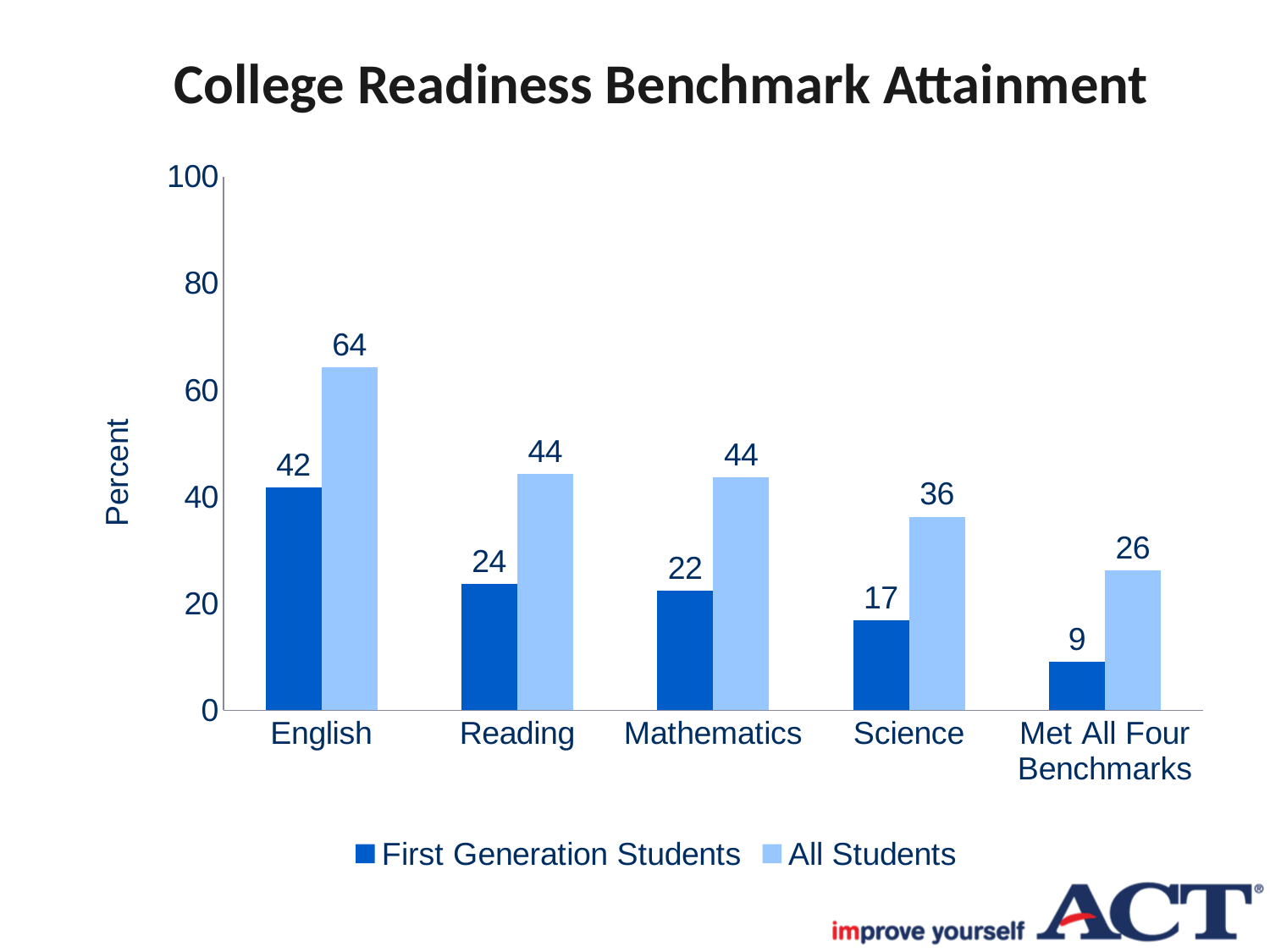
What is the value for All Students in Science? 36 Which category has the highest value for All Students? English Which is larger: the First Generation Students value for Reading or for Mathematics? Reading What is the difference between All Students and First Generation Students in English? 22 Is the value for All Students in Mathematics greater or less than 40? greater Which category has the lowest value for First Generation Students? Met All Four Benchmarks What is the value for First Generation Students in English? 42 How many categories are shown on the x axis? 5 What is the title of the chart? College Readiness Benchmark Attainment What kind of chart is shown on the slide? bar chart What is the value for First Generation Students for Met All Four Benchmarks? 9 How many series does the legend list? 2